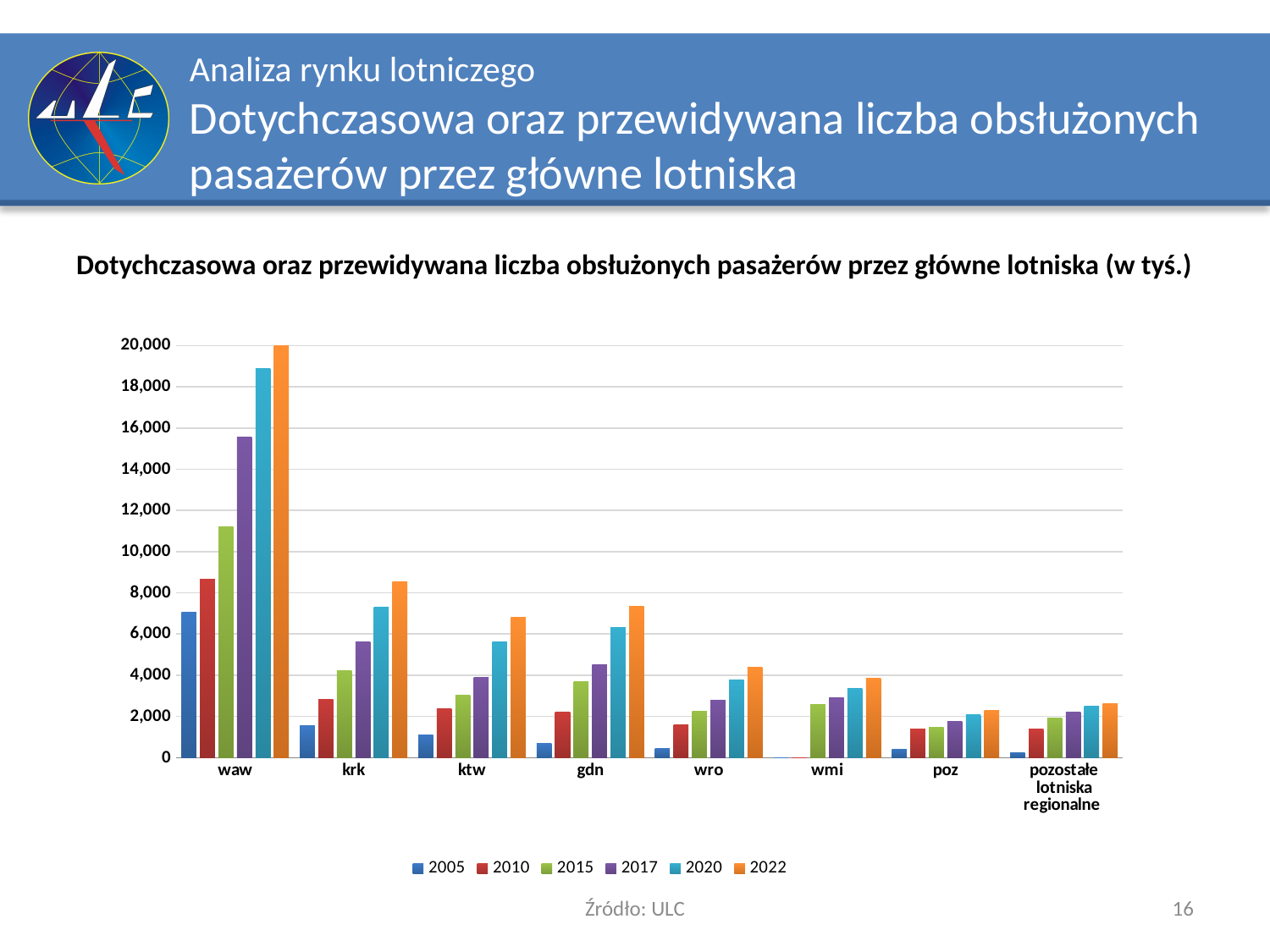
Which year is shown last in the legend? 2022 Is the value for wro in 2005 greater or less than 2,000? less Is the value for krk in 2022 greater or less than 8,000? greater Is the value for ktw in 2020 greater or less than 6,000? less Do the values for waw rise or fall from 2005 to 2022? rise How many series does the legend list? 6 What kind of chart is shown on the slide? bar chart Which is larger for 2022: the value for krk or the value for gdn? krk How many airport categories are shown on the x axis? 8 Which airport has the highest value for 2022? waw